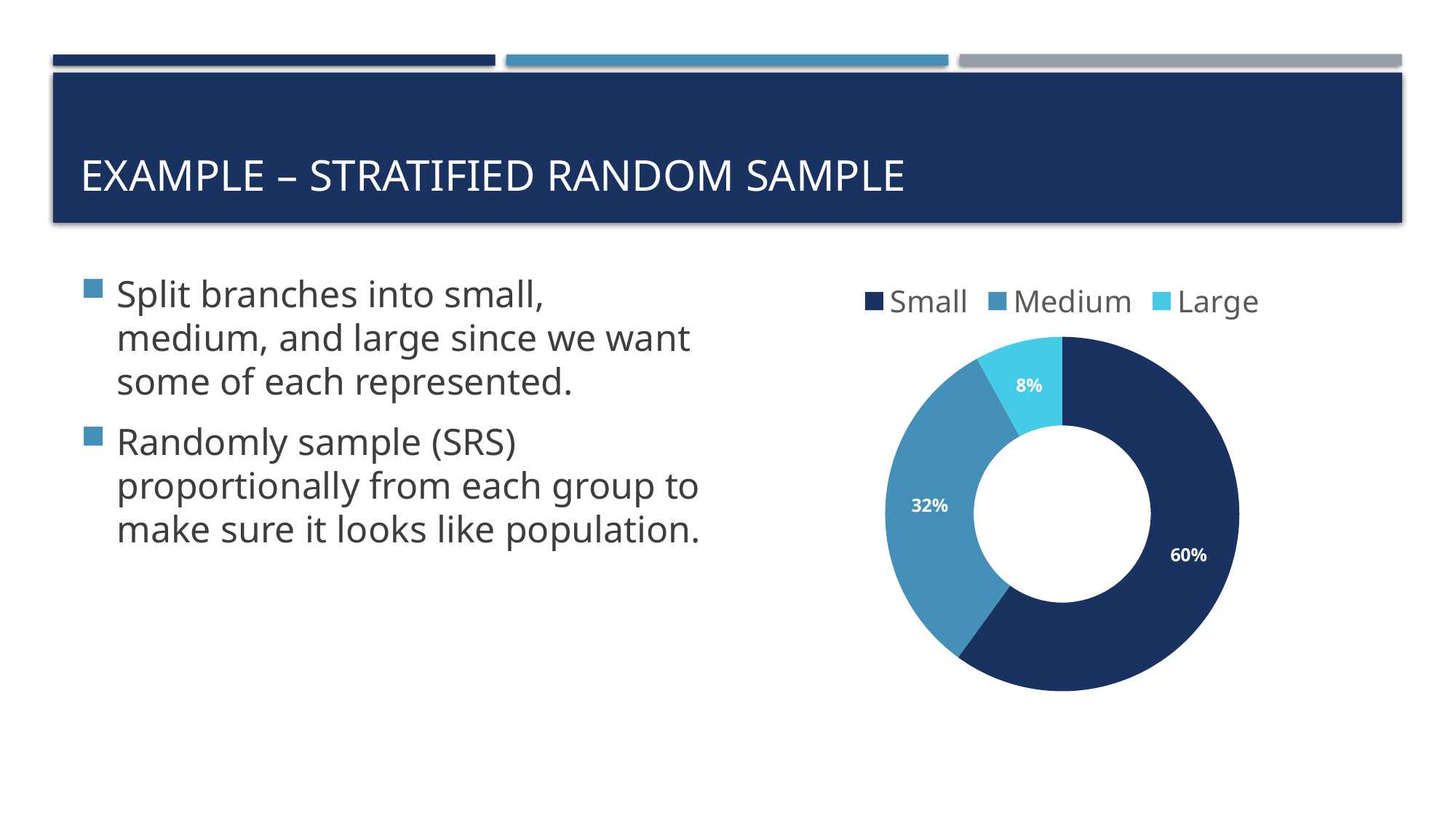
What kind of chart is shown on the slide? Doughnut chart How many categories does the chart show? 3 Which slice is larger, Medium or Large? Medium What percentage of the doughnut chart is the Small slice? 60% What colour is the Large slice in the chart? Light blue What percentage of the doughnut chart is the Large slice? 8% Which category has the largest share in the chart? Small What is the difference in percentage points between the Small and Medium slices? 28 Which category has the smallest share in the chart? Large What percentage of the doughnut chart is the Medium slice? 32% What is the difference in percentage points between the Medium and Large slices? 24 How many entries does the legend list? 3